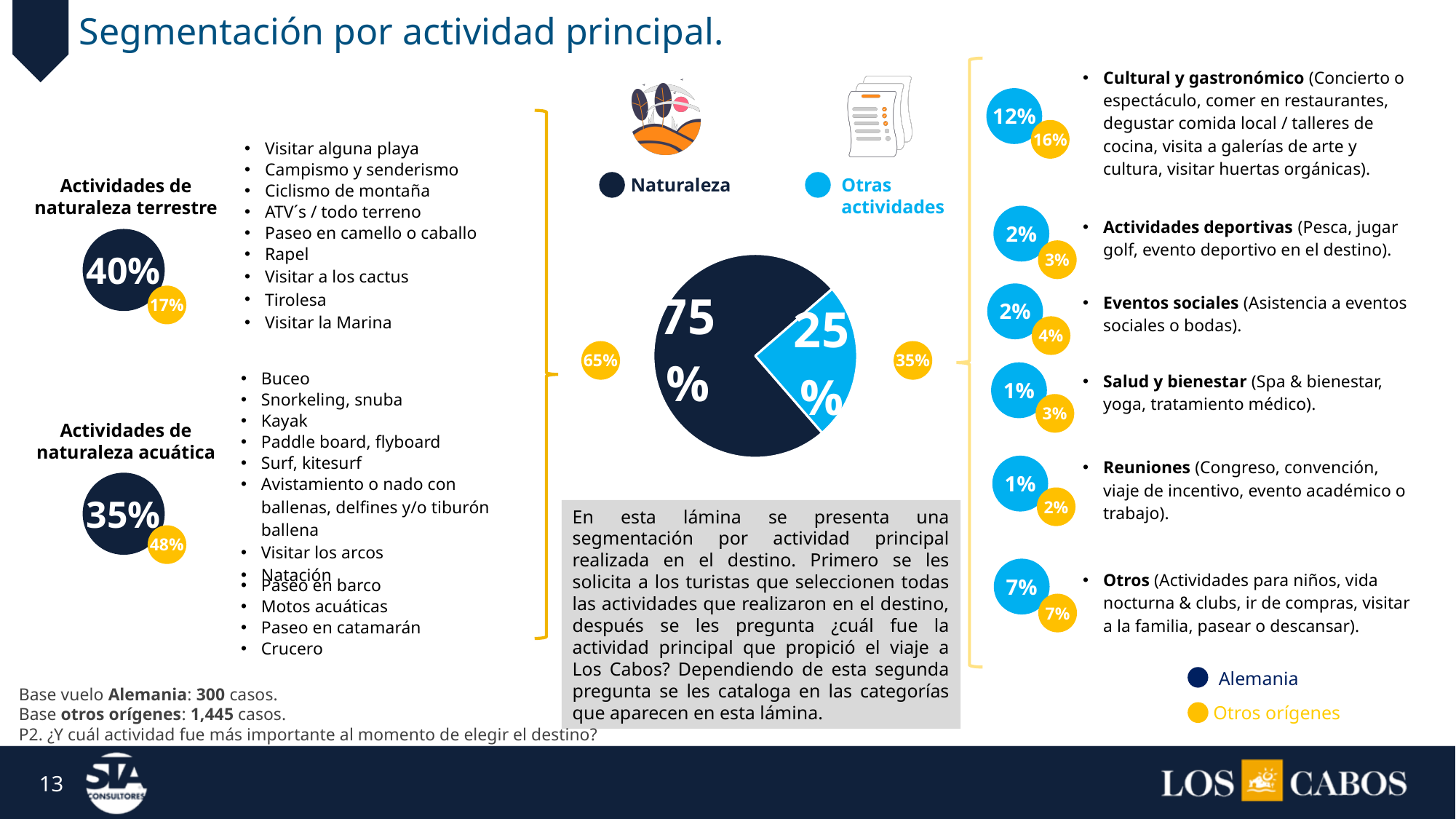
In the pie chart, what share is shown for Otras actividades? 25% What yellow value is shown next to the Naturaleza side of the pie chart for Otros orígenes? 65% How many categories does the legend above the pie chart list? 2 What is the difference in percentage points between the Naturaleza slice and the Otras actividades slice in the pie chart? 50 Is the Naturaleza share in the pie chart greater or less than 50%? greater What is the total of the two slices shown in the pie chart? 100% What kind of chart is shown in the centre of the slide? pie chart Which slice of the pie chart is larger, Naturaleza or Otras actividades? Naturaleza In the pie chart, what share is shown for Naturaleza? 75% What yellow value is shown next to the Otras actividades side of the pie chart for Otros orígenes? 35% How many slices does the pie chart have? 2 What colour is the Naturaleza slice in the pie chart? dark navy blue